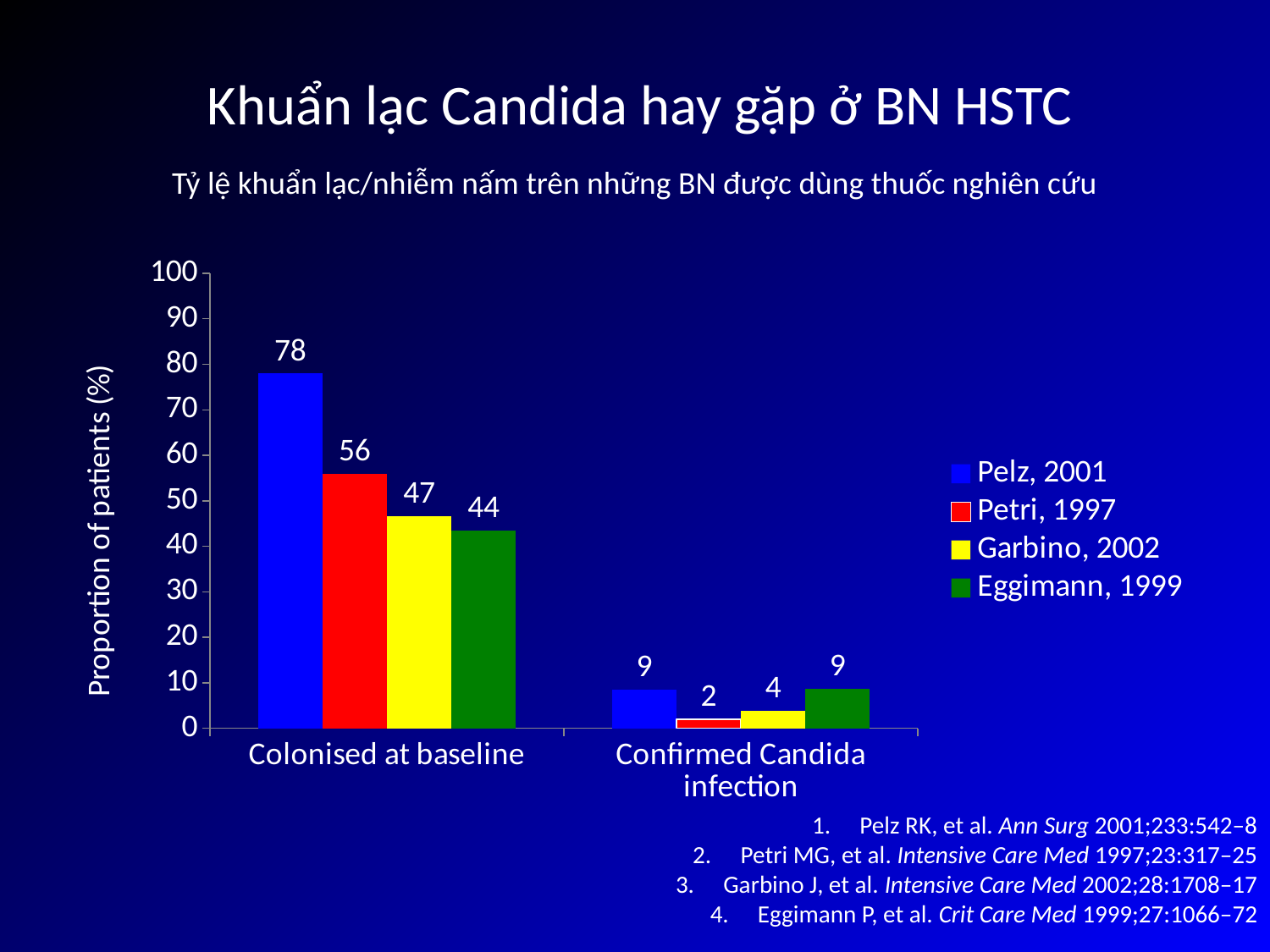
Which is larger: the Petri, 1997 value or the Garbino, 2002 value in the Colonised at baseline category? Petri, 1997 What kind of chart is shown on the slide? bar chart Which series has the lowest value in the Confirmed Candida infection category? Petri, 1997 Which series has the highest value in the Colonised at baseline category? Pelz, 2001 Is the value for Eggimann, 1999 in the Colonised at baseline category greater or less than 50? less How many series does the legend list? 4 What is the value for Pelz, 2001 in the Colonised at baseline category? 78 What is the value for Petri, 1997 in the Confirmed Candida infection category? 2 What is the value for Garbino, 2002 in the Colonised at baseline category? 47 How many categories are shown on the x axis? 2 What is the difference between the Pelz, 2001 and Eggimann, 1999 values in the Colonised at baseline category? 34 What is the label of the y axis? Proportion of patients (%)